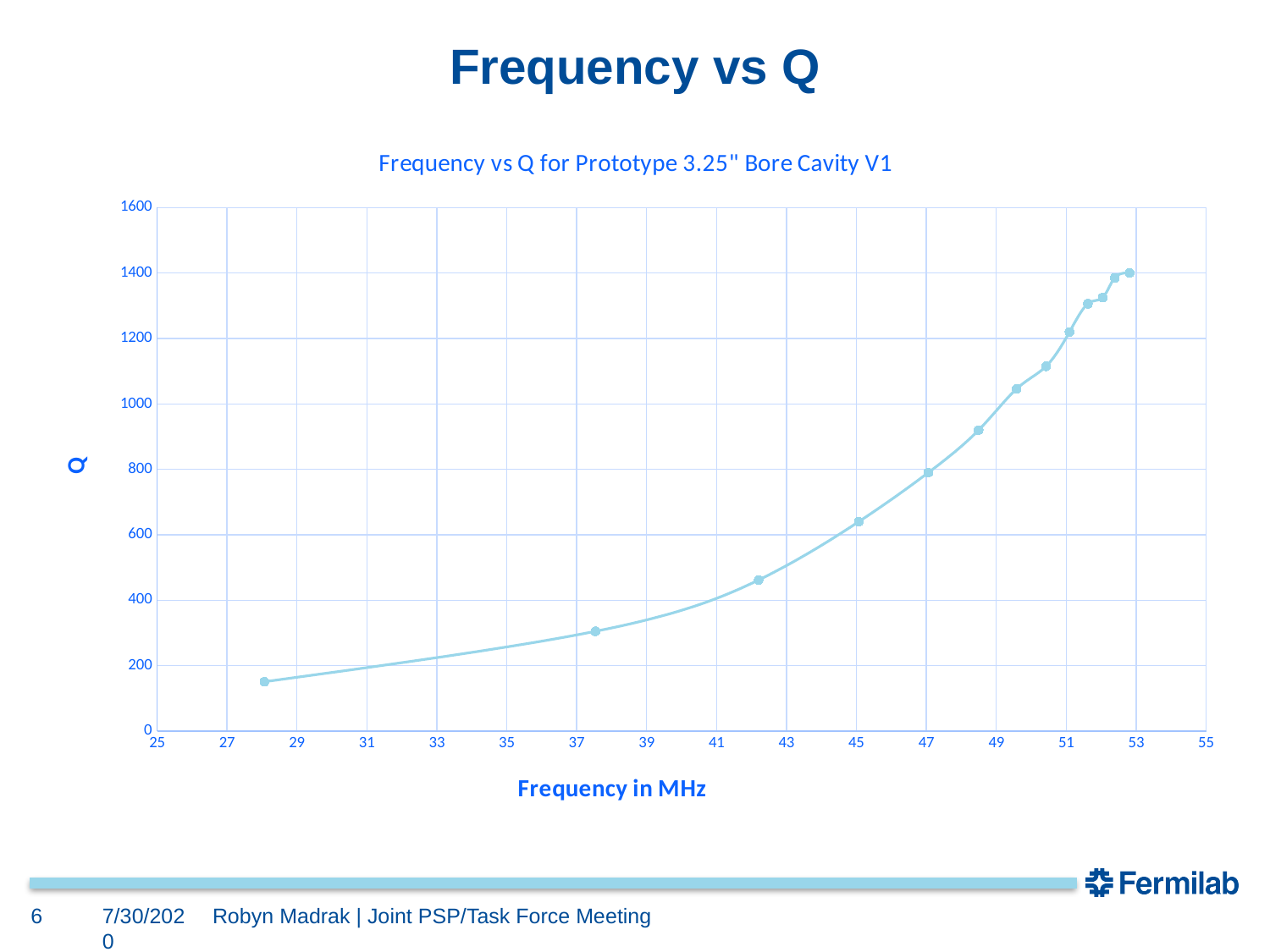
What kind of chart is shown on the slide? line chart Is the Q value for the point near 45 MHz greater or less than 600? greater Is the Q value for the point near 37.5 MHz greater or less than 400? less Is the Q value for the point near 48.5 MHz greater or less than 1000? less What is the label of the x axis? Frequency in MHz Which point has the higher Q: the one near 45 MHz or the one near 49.5 MHz? the one near 49.5 MHz What is the maximum value shown on the Q axis? 1600 Does Q rise or fall as frequency increases along the x axis? rise What is the title of the chart? Frequency vs Q for Prototype 3.25" Bore Cavity V1